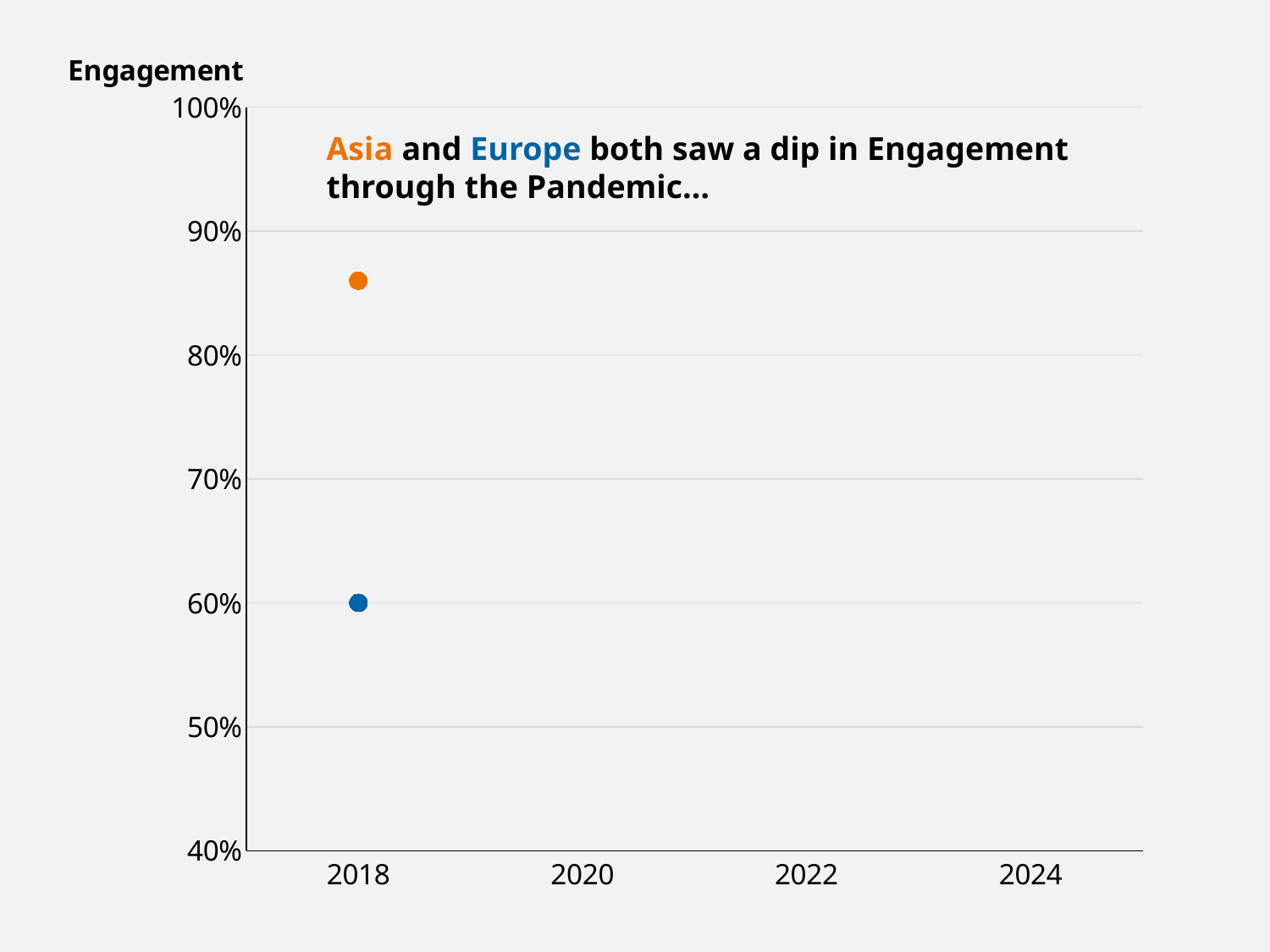
What is the title of the y axis? Engagement How many year labels are shown on the x axis? 4 How many data points are plotted on the chart? 2 What colour represents Asia on the chart? Orange How many series are plotted on the chart? 2 Which region has the higher Engagement in 2018, Asia or Europe? Asia Is the Engagement value for Asia in 2018 greater or less than 90%? less Is the Engagement value for Asia in 2018 greater or less than 80%? greater Is the Engagement value for Europe in 2018 greater or less than 70%? less Which series has the lowest plotted Engagement value on the chart? Europe What is the Engagement value for Europe in 2018? 60% Which series has the highest plotted Engagement value on the chart? Asia